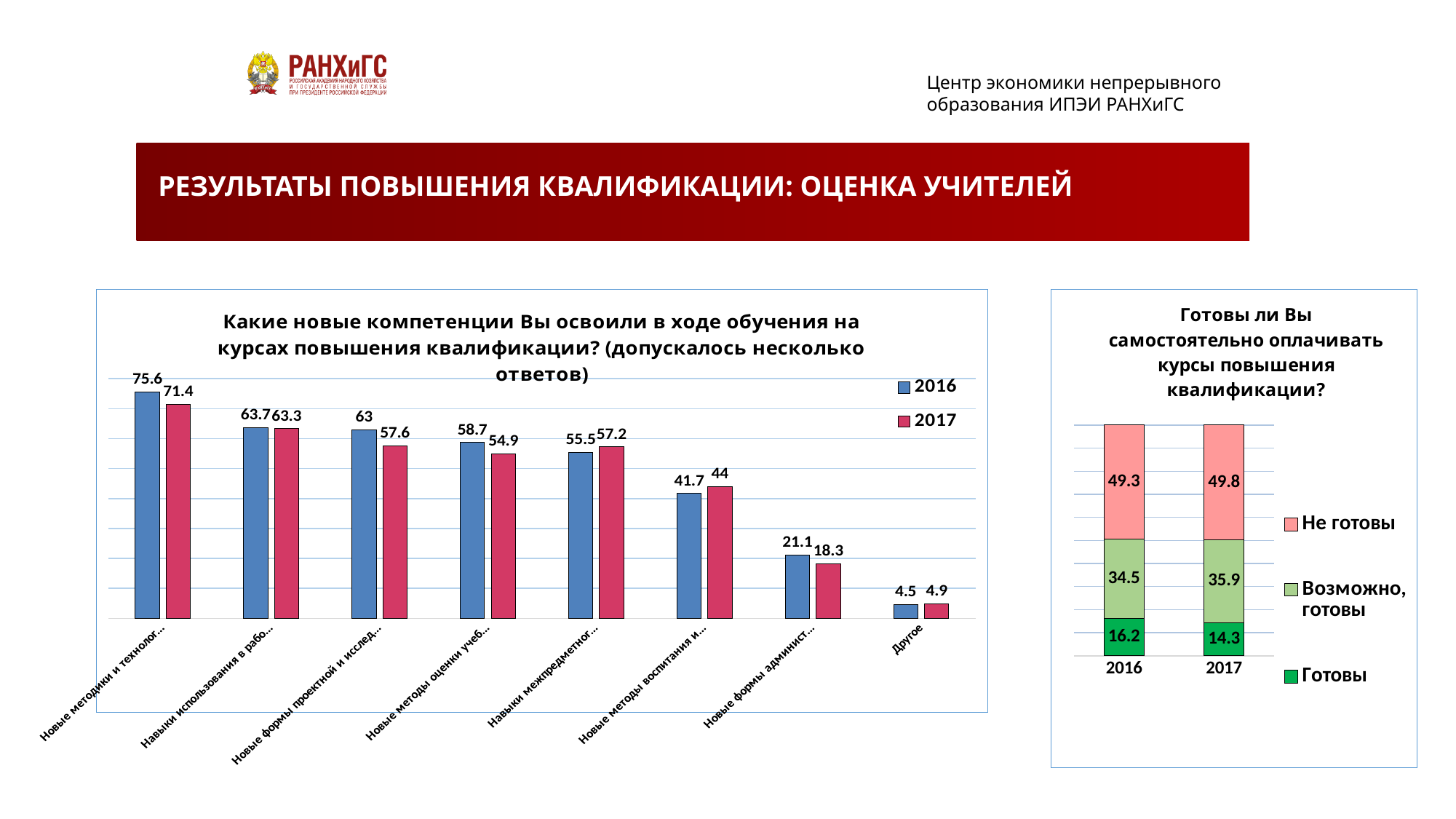
In the right chart, what is the total of the stacked bar for 2016? 100 What kind of chart is the left chart? bar chart In the left chart, how many series does the legend list? 2 In the right chart, what is the value for "Не готовы" in 2016? 49.3 In the right chart, what is the value for "Готовы" in 2017? 14.3 In the left chart, what is the 2017 value for the category "Другое"? 4.9 In the right chart, how many series does the legend list? 3 In the left chart, what is the highest value in the 2016 series? 75.6 In the left chart, what is the difference between the 2017 and 2016 values for "Другое"? 0.4 In the left chart, how many categories are shown on the x axis? 8 In the left chart, what is the 2016 value for the category "Другое"? 4.5 In the left chart, which series has the larger value for the leftmost category, 2016 or 2017? 2016